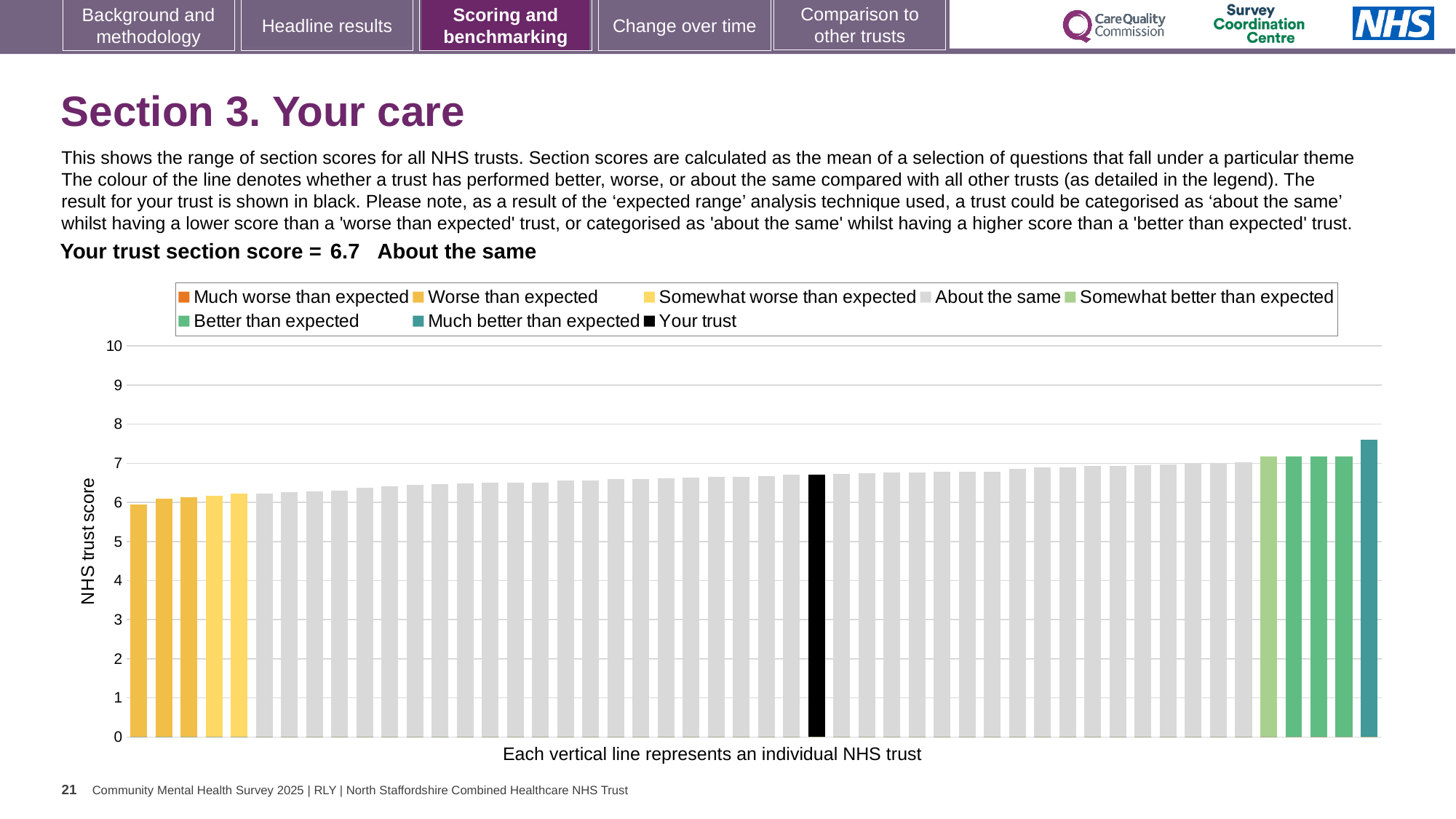
Is the value for your trust greater or less than 6? greater What is the label on the vertical axis? NHS trust score Is the value of the highest bar greater or less than 7? greater Which category is your trust placed in for this section? About the same What is the section score for your trust? 6.7 Is the value of the lowest bar greater or less than 7? less How many bars are coloured as 'Better than expected'? 3 How many entries does the chart legend list? 8 Which legend category does the shortest bar belong to? Worse than expected Which legend category does the tallest bar belong to? Much better than expected What kind of chart is shown on the slide? bar chart Do the bar values rise or fall from left to right along the x axis? rise